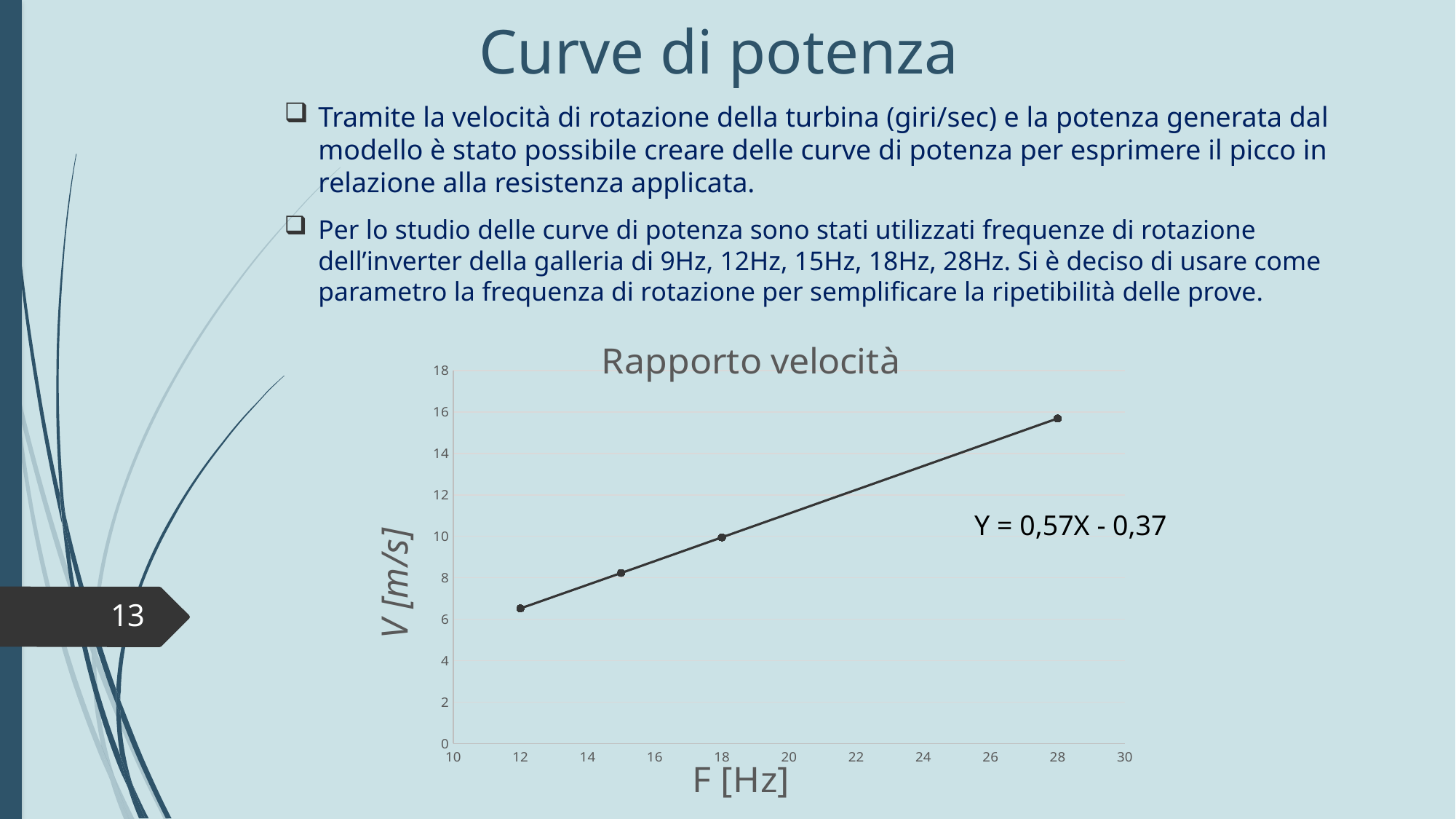
In the "Rapporto velocità" chart, does V rise or fall as F increases? rises What is the label of the vertical axis in the "Rapporto velocità" chart? V [m/s] In the "Rapporto velocità" chart, is the value of V at F = 12 Hz greater or less than 6? greater In the "Rapporto velocità" chart, is the value of V at F = 28 Hz greater or less than 14? greater How many data points are plotted in the "Rapporto velocità" chart? 4 At which frequency F is the plotted velocity V highest in the "Rapporto velocità" chart? 28 What equation is shown next to the line in the "Rapporto velocità" chart? Y = 0,57X - 0,37 In the "Rapporto velocità" chart, is the value of V at F = 28 Hz greater or less than 16? less At which frequency F is the plotted velocity V lowest in the "Rapporto velocità" chart? 12 What kind of chart is "Rapporto velocità"? line chart In the "Rapporto velocità" chart, which has the larger V: the point at F = 15 Hz or the point at F = 18 Hz? F = 18 Hz